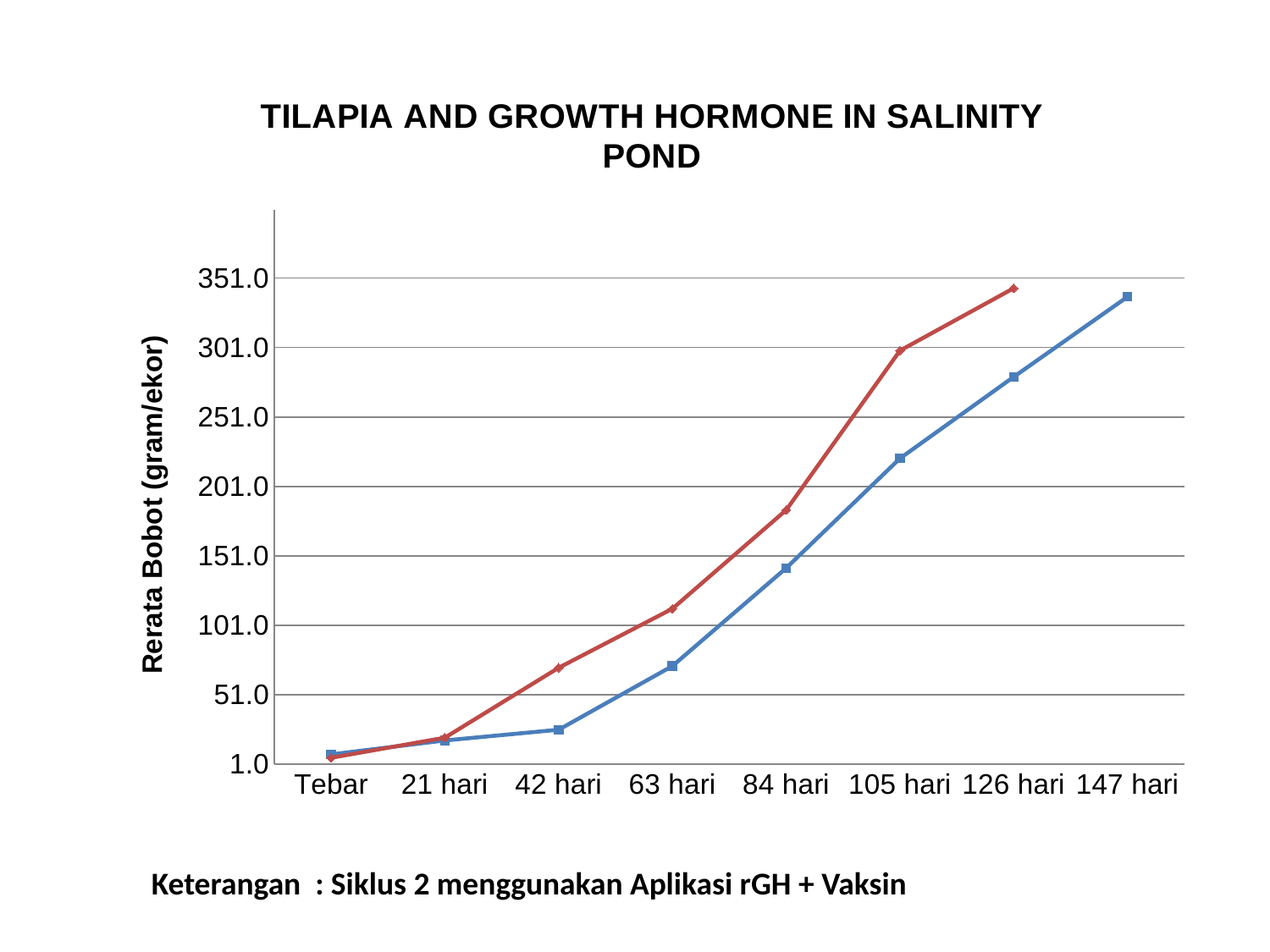
Is the value of the red line at 126 hari greater or less than 301.0? greater Is the value of the red line at 84 hari greater or less than 151.0? greater At which x-axis category does the blue line reach its highest value? 147 hari How many categories are shown on the x axis? 8 What is the label of the y axis? Rerata Bobot (gram/ekor) What kind of chart is shown on the slide? line chart Is the value of the blue line at 42 hari greater or less than 51.0? less Do the values of the blue line rise or fall from Tebar to 147 hari? rise At 84 hari, which line has the higher value, the red line or the blue line? the red line What is the title of the chart? TILAPIA AND GROWTH HORMONE IN SALINITY POND